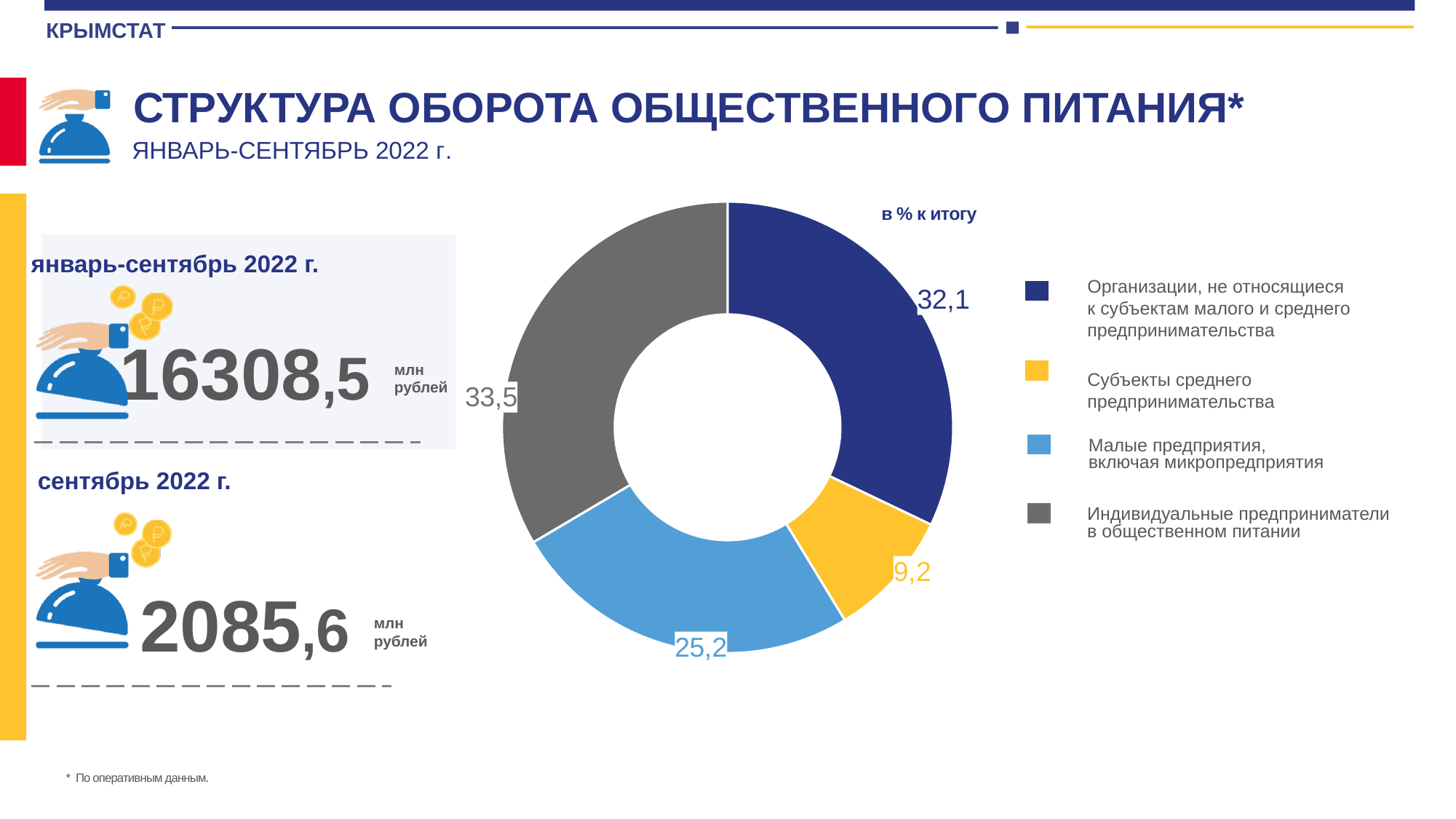
Which category has the smallest share in the chart? Субъекты среднего предпринимательства What share is shown for 'Малые предприятия, включая микропредприятия'? 25,2 How many slices does the chart have? 4 What share of public catering turnover is attributed to 'Индивидуальные предприниматели в общественном питании'? 33,5 What share is shown for 'Организации, не относящиеся к субъектам малого и среднего предпринимательства'? 32,1 What is the difference between the shares of 'Индивидуальные предприниматели в общественном питании' and 'Организации, не относящиеся к субъектам малого и среднего предпринимательства'? 1,4 What type of chart is shown on the slide? Pie (donut) chart Which category has the largest share in the chart? Индивидуальные предприниматели в общественном питании What unit label is shown above the chart? в % к итогу What share is shown for 'Субъекты среднего предпринимательства'? 9,2 What colour represents 'Субъекты среднего предпринимательства' in the chart? Yellow Which is larger: the share of 'Малые предприятия, включая микропредприятия' or the share of 'Субъекты среднего предпринимательства'? Малые предприятия, включая микропредприятия